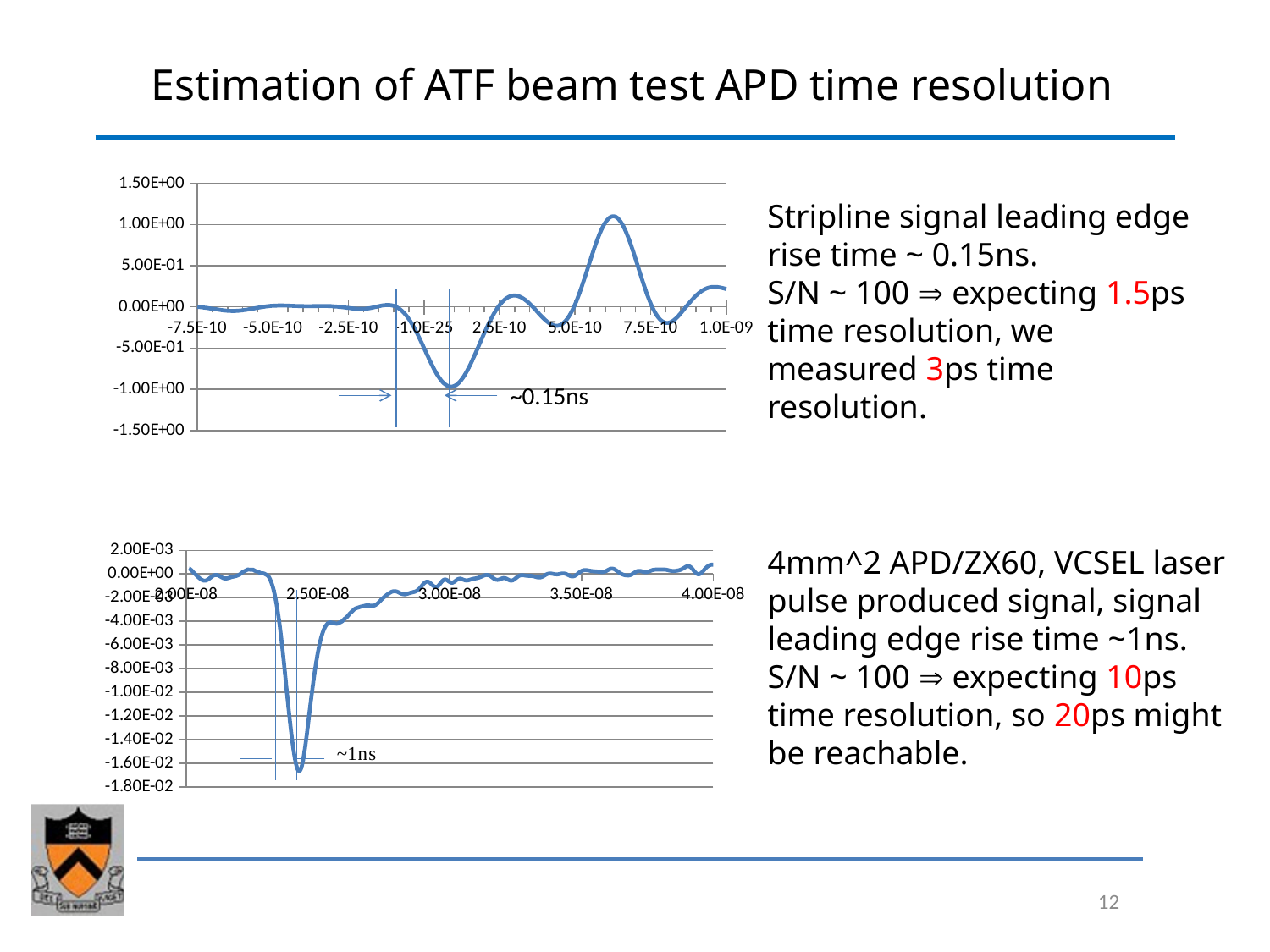
In the top chart, what is the highest value shown on the vertical axis? 1.50E+00 In the top chart, what time width is annotated next to the arrows at the trough? ~0.15ns In the bottom chart, is the lowest value of the line greater or less than -1.80E-02? greater In the top chart, is the lowest value of the line greater or less than -5.00E-01? less In the bottom chart, is the lowest value of the line greater or less than -1.40E-02? less In the bottom chart, what time width is annotated next to the trough? ~1ns In the bottom chart, what is the lowest value shown on the vertical axis? -1.80E-02 What kind of chart is the top chart on the slide? line chart What kind of chart is the bottom chart on the slide? line chart How many charts are shown on the slide? 2